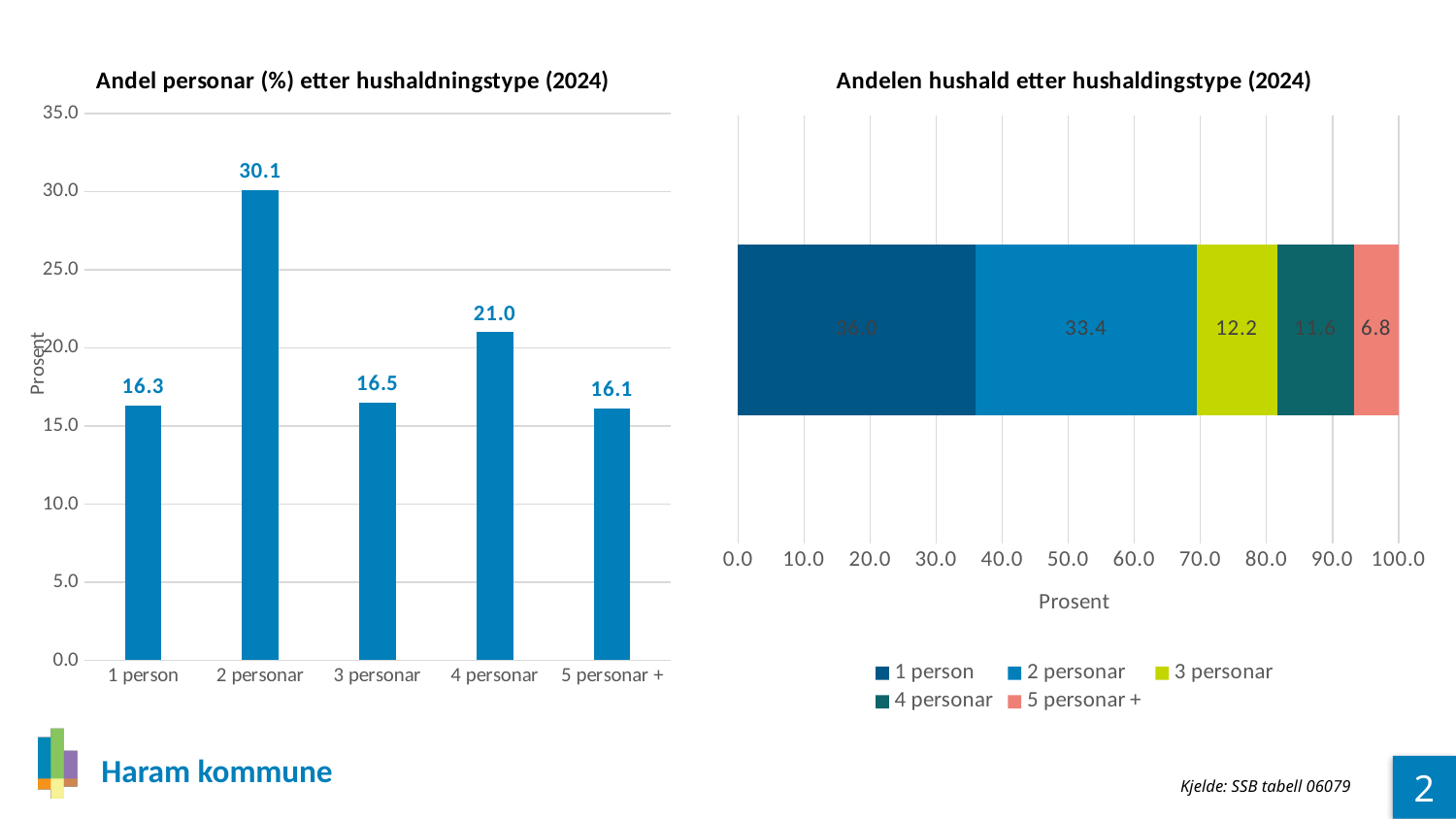
In the chart 'Andel personar (%) etter hushaldningstype (2024)', which household type has the highest share? 2 personar In the chart 'Andel personar (%) etter hushaldningstype (2024)', which is larger: the value for 3 personar or the value for 4 personar? 4 personar In the chart 'Andelen hushald etter hushaldingstype (2024)', what is the value for 5 personar +? 6.8 In the chart 'Andelen hushald etter hushaldingstype (2024)', which is larger: the value for 3 personar or the value for 5 personar +? 3 personar What kind of chart is 'Andel personar (%) etter hushaldningstype (2024)'? Bar chart In the chart 'Andelen hushald etter hushaldingstype (2024)', what is the value for 2 personar? 33.4 In the chart 'Andel personar (%) etter hushaldningstype (2024)', which household type has the lowest share? 5 personar + In the chart 'Andel personar (%) etter hushaldningstype (2024)', how many household types are shown on the x axis? 5 In the chart 'Andel personar (%) etter hushaldningstype (2024)', what is the difference between the values for 2 personar and 1 person? 13.8 In the chart 'Andel personar (%) etter hushaldningstype (2024)', what is the value for 2 personar? 30.1 In the chart 'Andel personar (%) etter hushaldningstype (2024)', what is the value for 4 personar? 21.0 In the chart 'Andelen hushald etter hushaldingstype (2024)', how many series does the legend list? 5